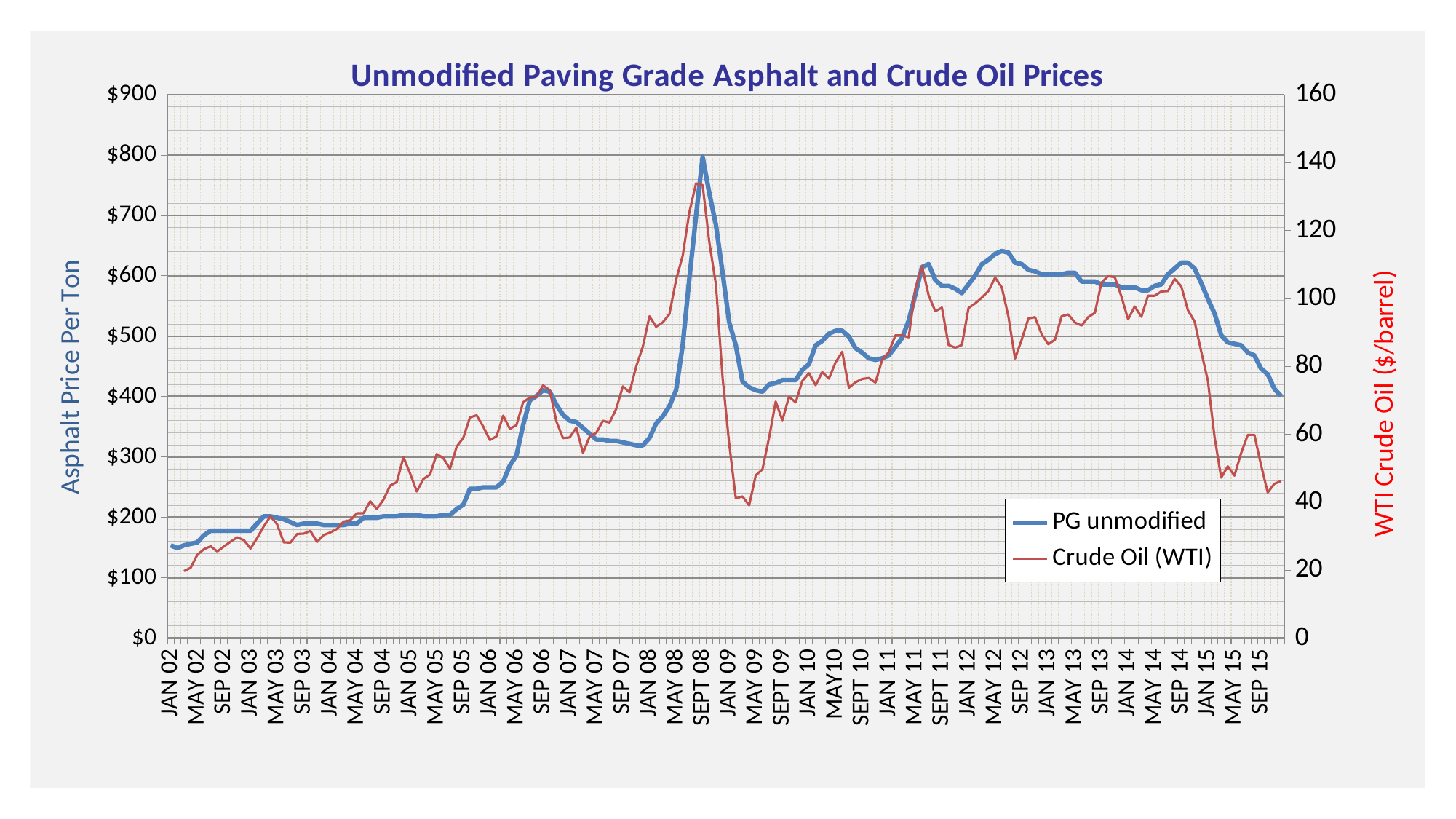
Is the Crude Oil (WTI) value at MAY 09 greater or less than 60? less In which month does the PG unmodified series reach its highest value? SEPT 08 Is the PG unmodified value at SEPT 08 greater or less than $700? greater Is the PG unmodified value at JAN 02 greater or less than $200? less How many series does the legend list? 2 Does the PG unmodified series rise or fall between SEP 14 and the end of the chart? Fall What kind of chart is shown on the slide? Line chart Is the PG unmodified value higher at SEPT 08 or at MAY 12? SEPT 08 What is the title of the chart? Unmodified Paving Grade Asphalt and Crude Oil Prices What is the label of the right-hand vertical axis? WTI Crude Oil ($/barrel)